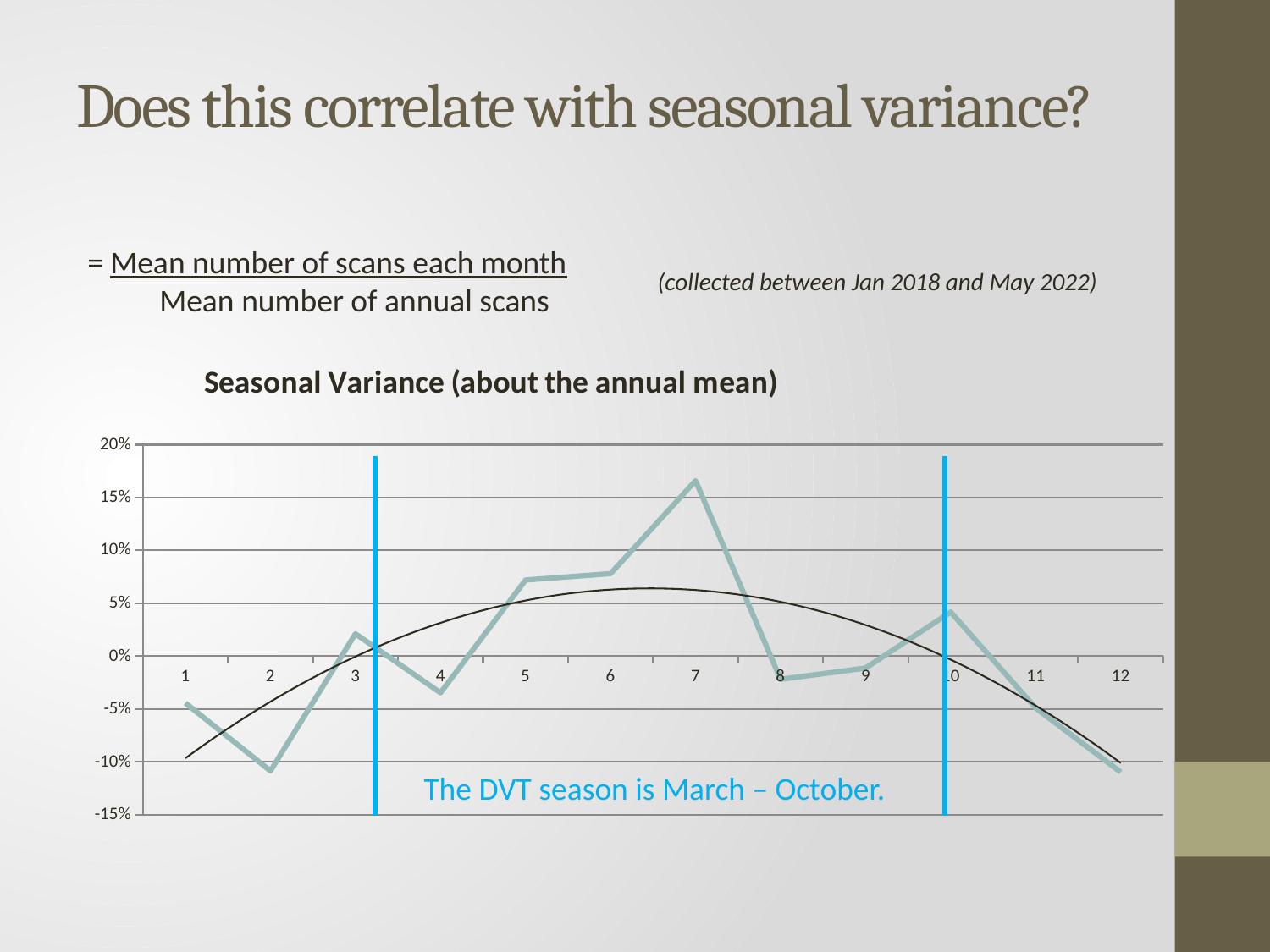
Is the value for month 10 greater or less than 0%? greater Is the value for month 7 greater or less than 15%? greater How many months are plotted along the x axis of the chart? 12 What type of chart is shown on the slide? line chart Is the value for month 12 greater or less than -5%? less Which has the larger value, month 3 or month 4? month 3 What is the title of the chart? Seasonal Variance (about the annual mean) Do the values rise or fall from month 4 to month 7? rise According to the text on the chart, which months make up the DVT season? March – October Which month has the highest seasonal variance value? 7